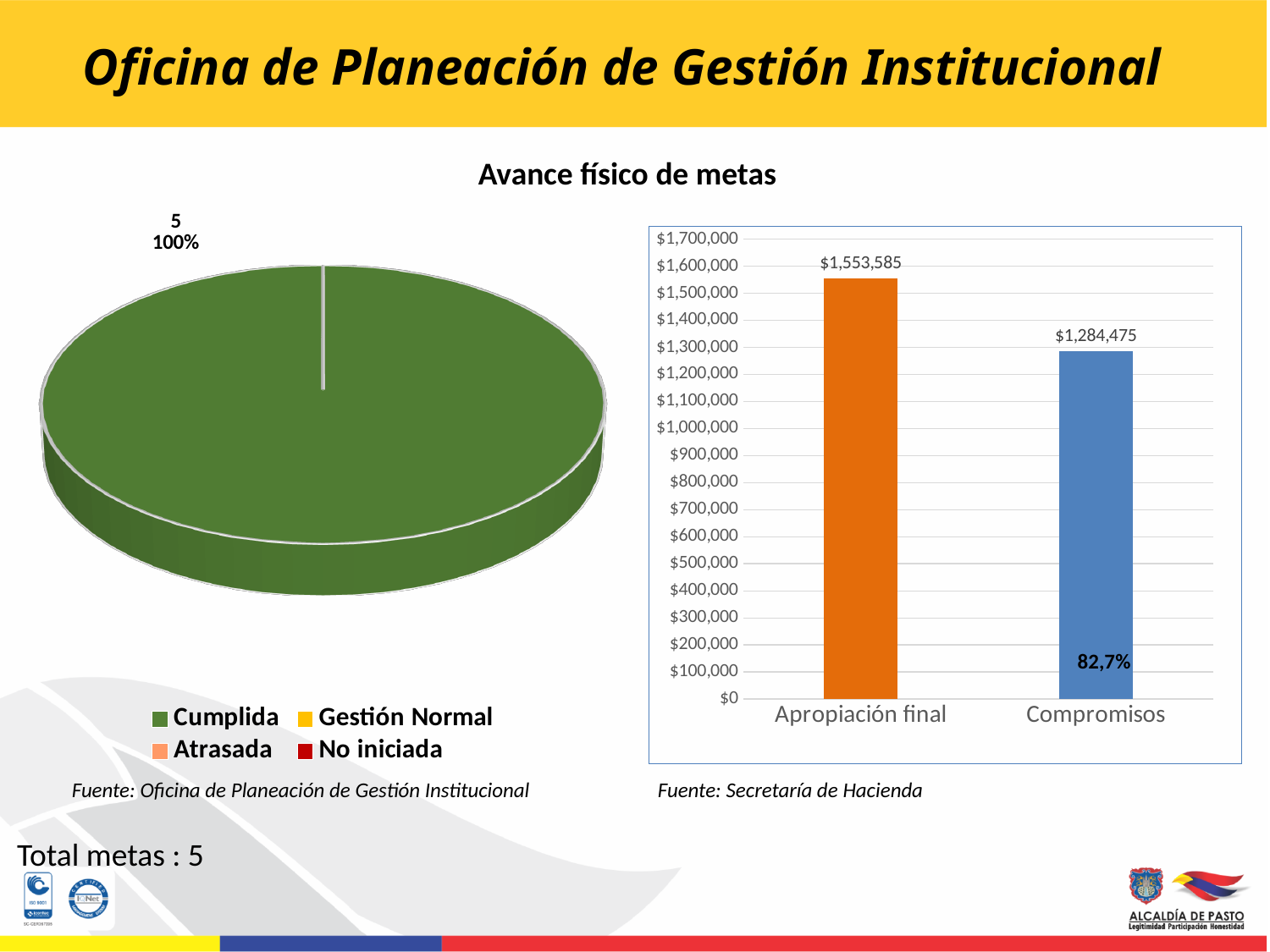
On the bar chart on the right, how many categories are plotted? 2 What kind of chart is shown on the left side of the slide? Pie chart On the bar chart on the right, what is the value for Compromisos? $1,284,475 On the pie chart on the left, what count is shown for the Cumplida slice? 5 On the bar chart on the right, what is the value for Apropiación final? $1,553,585 On the bar chart on the right, which category has the higher value, Apropiación final or Compromisos? Apropiación final On the bar chart on the right, what is the difference between Apropiación final and Compromisos? $269,110 What kind of chart is shown on the right side of the slide? Bar chart How many entries does the legend of the pie chart on the left list? 4 On the pie chart on the left, what share of the pie does the Cumplida slice represent? 100% On the bar chart on the right, what percentage label is shown on the Compromisos bar? 82,7%